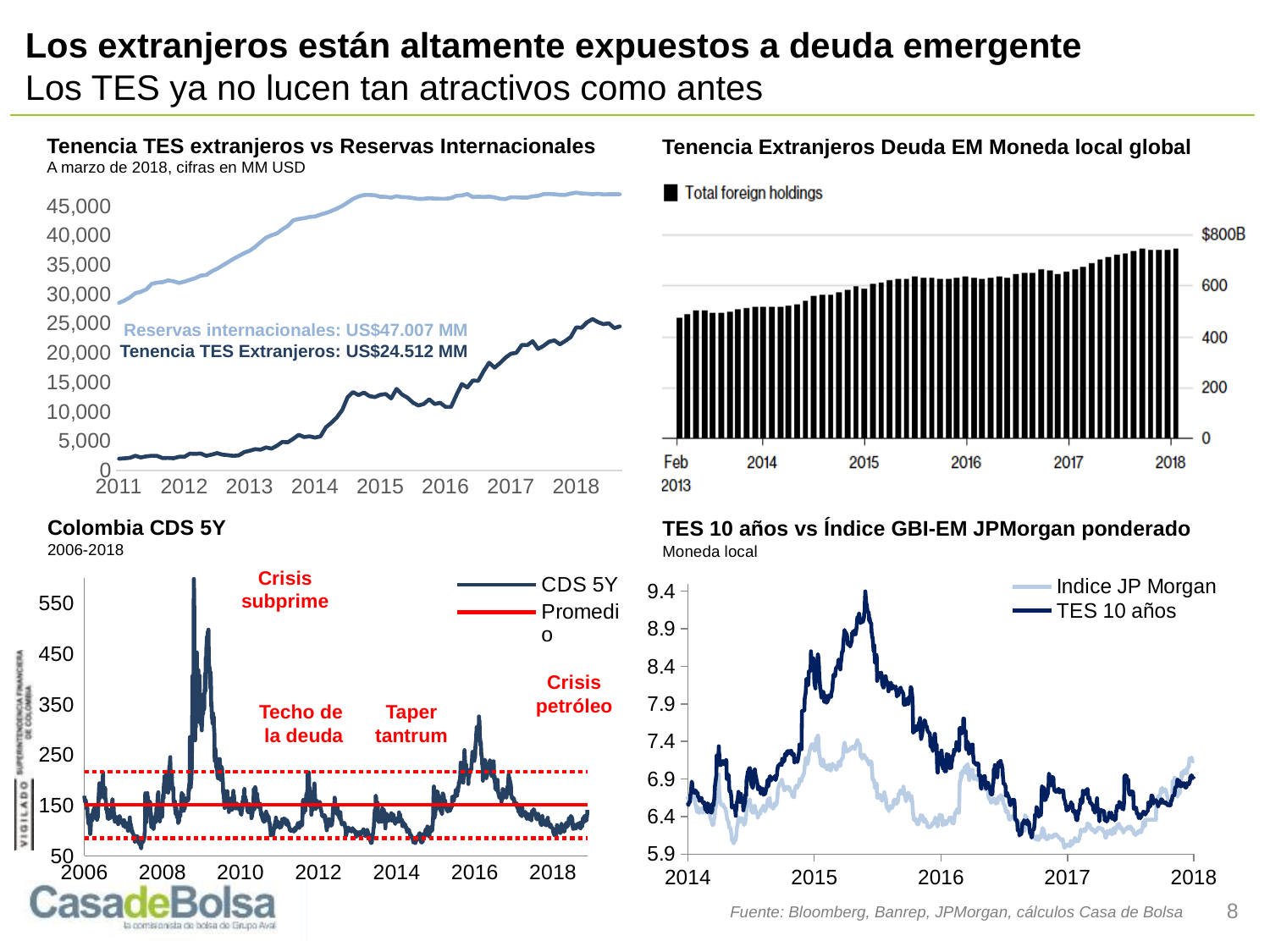
What kind of chart is 'Tenencia Extranjeros Deuda EM Moneda local global' (top right)? Bar chart What kind of chart is 'Colombia CDS 5Y' (bottom left)? Line chart How many series does the legend of the 'Colombia CDS 5Y' chart list? 2 In the 'Tenencia Extranjeros Deuda EM Moneda local global' chart, do total foreign holdings rise or fall from 2013 to 2018? Rise What are the two legend entries in the 'TES 10 años vs Índice GBI-EM JPMorgan ponderado' chart? Indice JP Morgan and TES 10 años In the 'Tenencia Extranjeros Deuda EM Moneda local global' chart, is the value of total foreign holdings in 2018 greater or less than 600? greater In the 'Tenencia TES extranjeros vs Reservas Internacionales' chart, what is the difference between the Reservas internacionales value and the Tenencia TES Extranjeros value? US$22.495 MM In the 'Tenencia TES extranjeros vs Reservas Internacionales' chart, which is larger, Reservas internacionales or Tenencia TES Extranjeros? Reservas internacionales In the 'Tenencia TES extranjeros vs Reservas Internacionales' chart, what value is given for Reservas internacionales? US$47.007 MM In the 'TES 10 años vs Índice GBI-EM JPMorgan ponderado' chart, is the peak value of TES 10 años in 2015 greater or less than 8.9? greater In the 'Tenencia TES extranjeros vs Reservas Internacionales' chart, what value is given for Tenencia TES Extranjeros? US$24.512 MM In the 'Tenencia TES extranjeros vs Reservas Internacionales' chart, is the Tenencia TES Extranjeros value in 2011 greater or less than 5,000? less